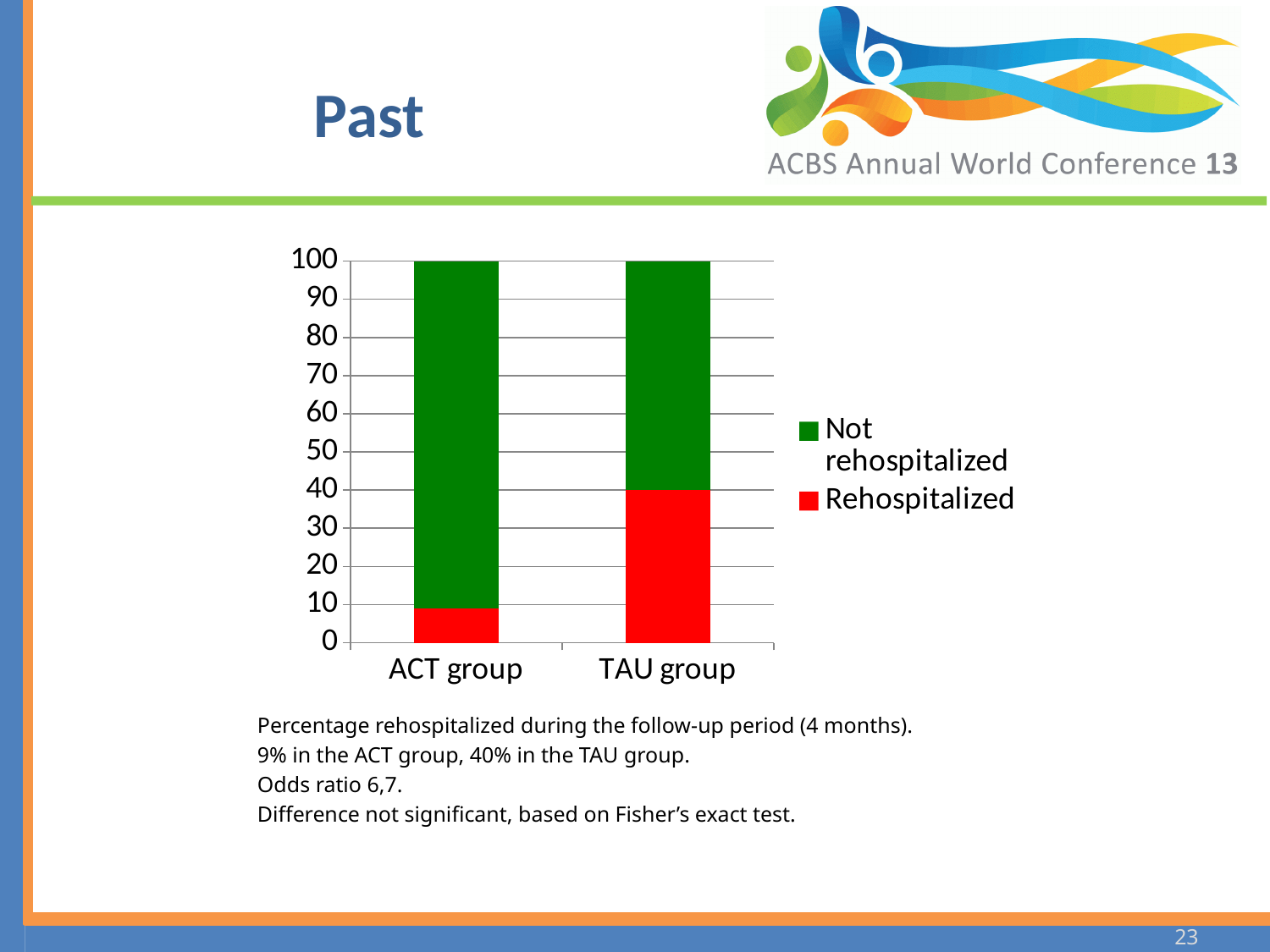
What is the difference between the rehospitalized percentages of the TAU group and the ACT group? 31 percentage points What is the total height of the stacked bar for the TAU group? 100 What percentage of the TAU group was rehospitalized? 40% Which colour represents the 'Rehospitalized' series in the chart? Red Is the 'Not rehospitalized' value for the TAU group greater or less than 70? less What percentage of the ACT group was rehospitalized? 9% Is the 'Not rehospitalized' value for the ACT group greater or less than 80? greater How many groups (categories) are shown on the x axis of the chart? 2 Which group has the lowest rehospitalized value? ACT group How many series does the chart's legend list? 2 Which group has the higher rehospitalized share, ACT group or TAU group? TAU group What kind of chart is shown on the slide? Stacked bar chart